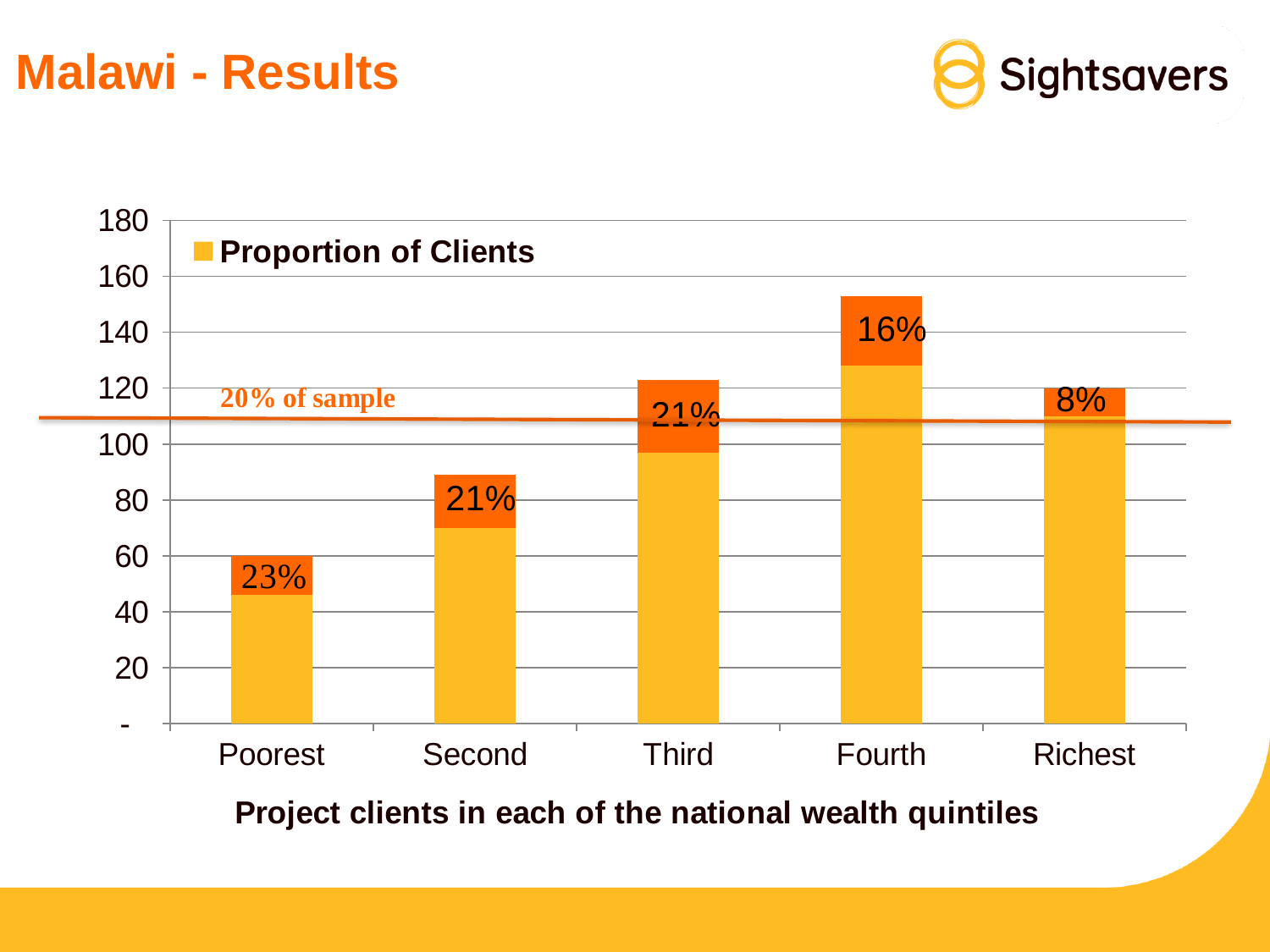
What percentage label is shown on the Fourth bar? 16% Is the bar for Poorest greater or less than 80? less What percentage label is shown on the Second bar? 21% What percentage label is shown on the Richest bar? 8% Which wealth quintile has the shortest bar? Poorest What percentage label is shown on the Poorest bar? 23% What kind of chart is shown on the slide? Bar chart Is the bar for Fourth greater or less than 140? greater What does the horizontal line across the chart represent, according to its label? 20% of sample Which bar is taller, Second or Richest? Richest Which wealth quintile has the tallest bar? Fourth How many wealth quintiles are shown on the x axis? 5